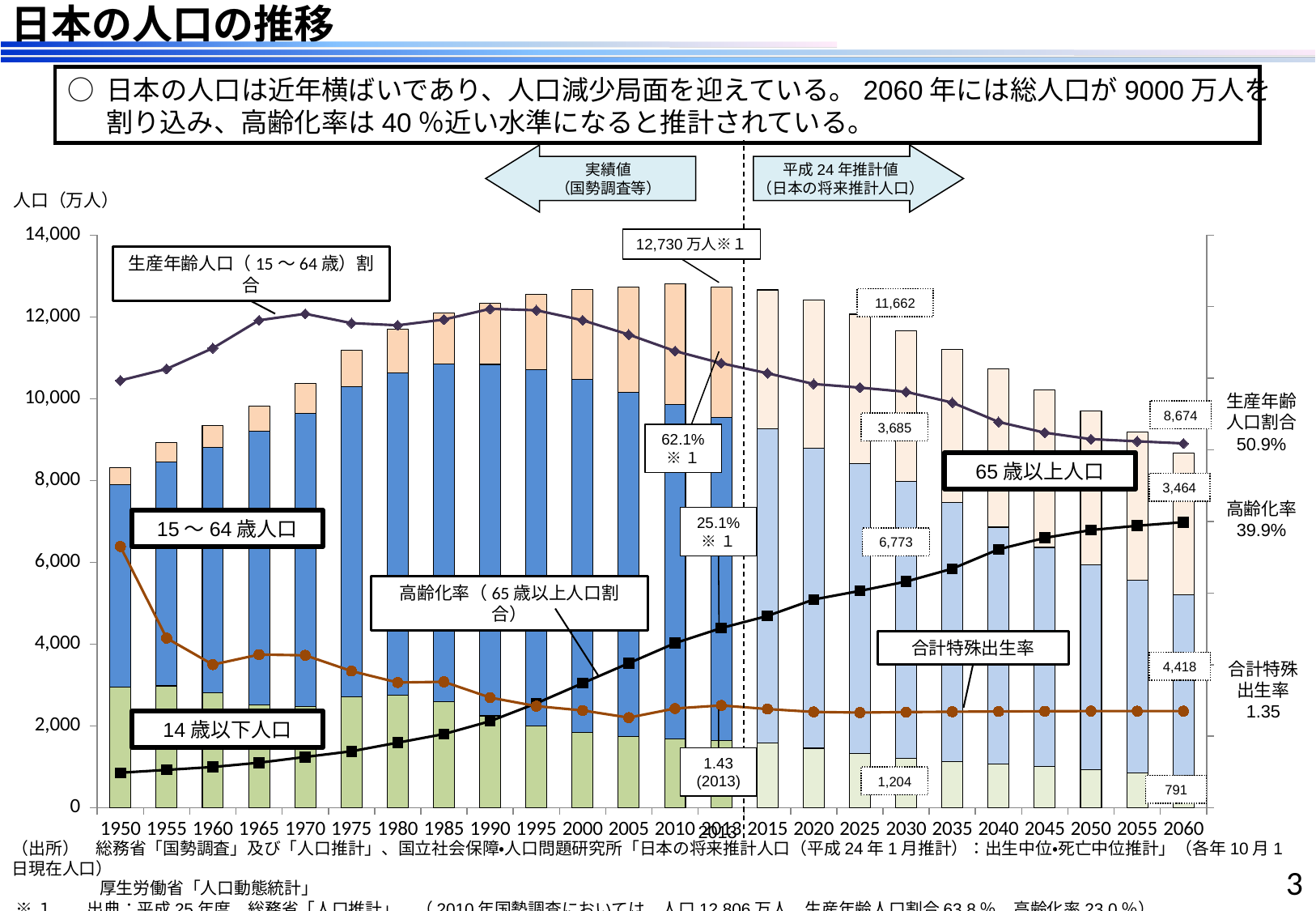
What is the labelled value of the 65歳以上人口 segment for 2030? 3,685 What is the labelled total population for 2060? 8,674 What is the 高齢化率 (aging rate) shown for 2013? 25.1% What is the difference between the labelled total population for 2030 (11,662) and for 2060 (8,674)? 2,988 What is the total population value labelled for 2013 on the chart? 12,730万人 Does the 高齢化率 line rise or fall from 1950 to 2060? rises For 2060, which is larger: the 65歳以上人口 segment or the 14歳以下人口 segment? 65歳以上人口 What is the total of the three labelled segments for 2030 (3,685, 6,773 and 1,204)? 11,662 Is the total population bar for 1950 greater or less than 10,000? less What is the 生産年齢人口割合 (working-age population ratio) shown for 2060? 50.9% What unit is shown on the vertical axis label of the chart? 人口（万人） What is the 合計特殊出生率 (total fertility rate) labelled for 2013? 1.43